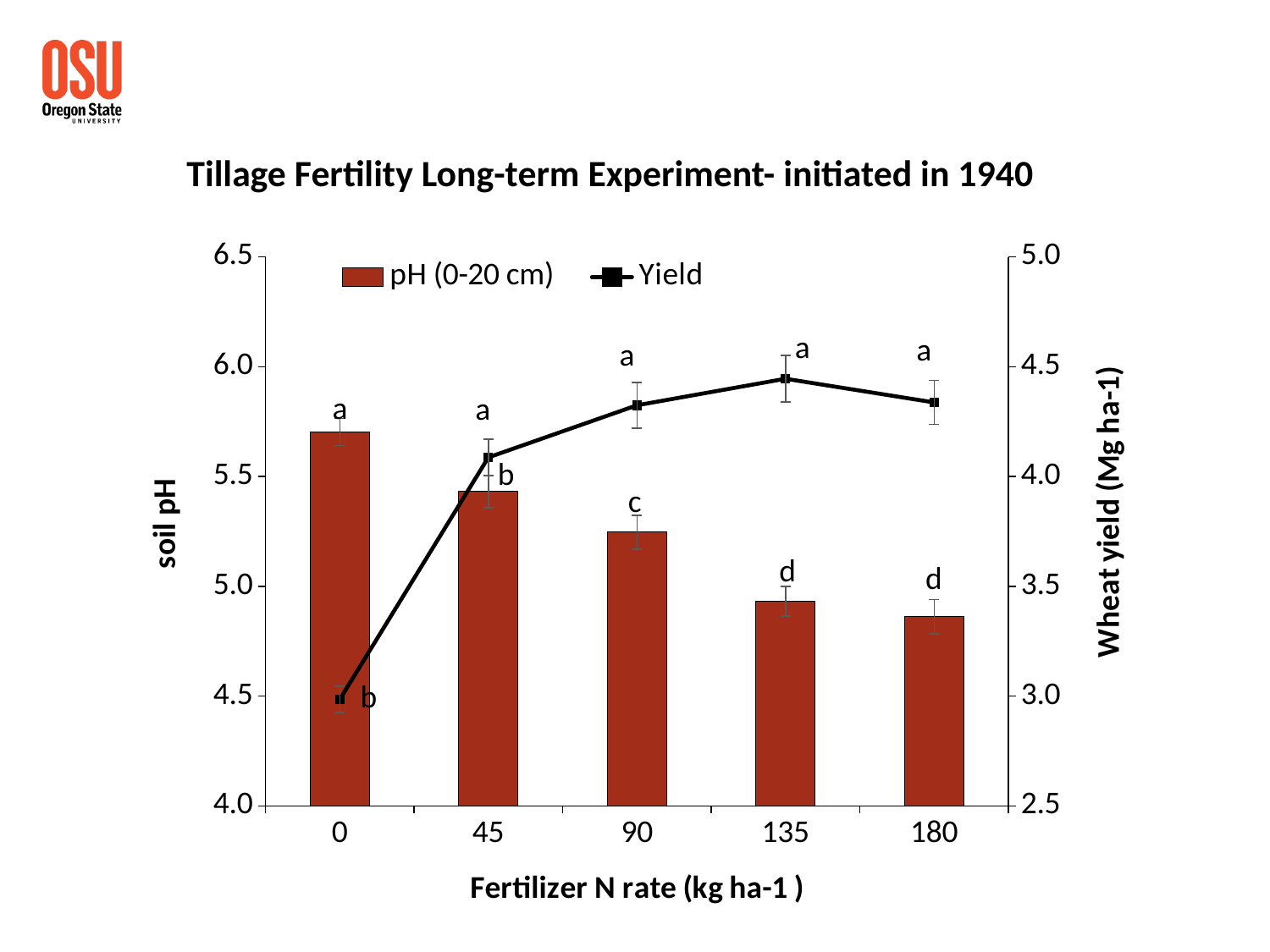
Is the wheat yield at N rate 90 greater or less than 4.0? greater What kind of chart is shown on the slide? A combination bar and line chart Does soil pH rise or fall as the fertilizer N rate increases from 0 to 180? Falls At which fertilizer N rate is wheat yield highest? 135 Is the soil pH value at N rate 135 greater or less than 5.0? less Which has the higher soil pH: N rate 45 or N rate 90? 45 How many series does the legend list? 2 At which fertilizer N rate is soil pH (0-20 cm) highest? 0 How many fertilizer N rate categories are shown on the x axis? 5 At which fertilizer N rate is wheat yield lowest? 0 Is the soil pH value at N rate 0 greater or less than 5.5? greater What is the title of the chart? Tillage Fertility Long-term Experiment- initiated in 1940